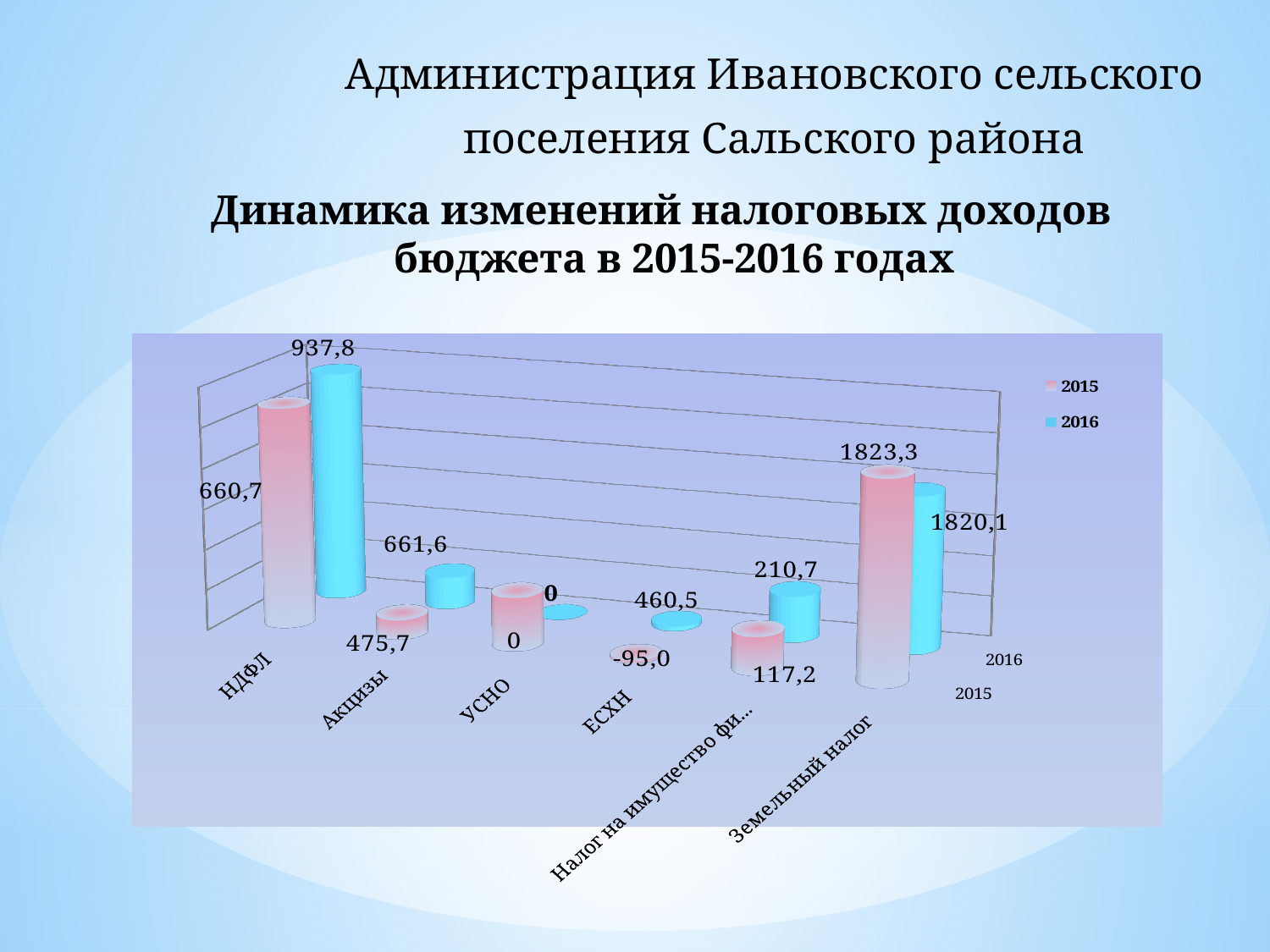
How many tax categories are shown on the x axis? 6 What is the 2015 value for НДФЛ? 660,7 By how much did the НДФЛ value increase from 2015 to 2016? 277,1 Which is larger for Акцизы: the 2015 value or the 2016 value? 2016 What is the difference between the 2016 and 2015 values for Акцизы? 185,9 What is the 2016 value for Акцизы? 661,6 What is the 2016 value for НДФЛ? 937,8 What is the 2015 value for Земельный налог? 1823,3 How many series does the legend list? 2